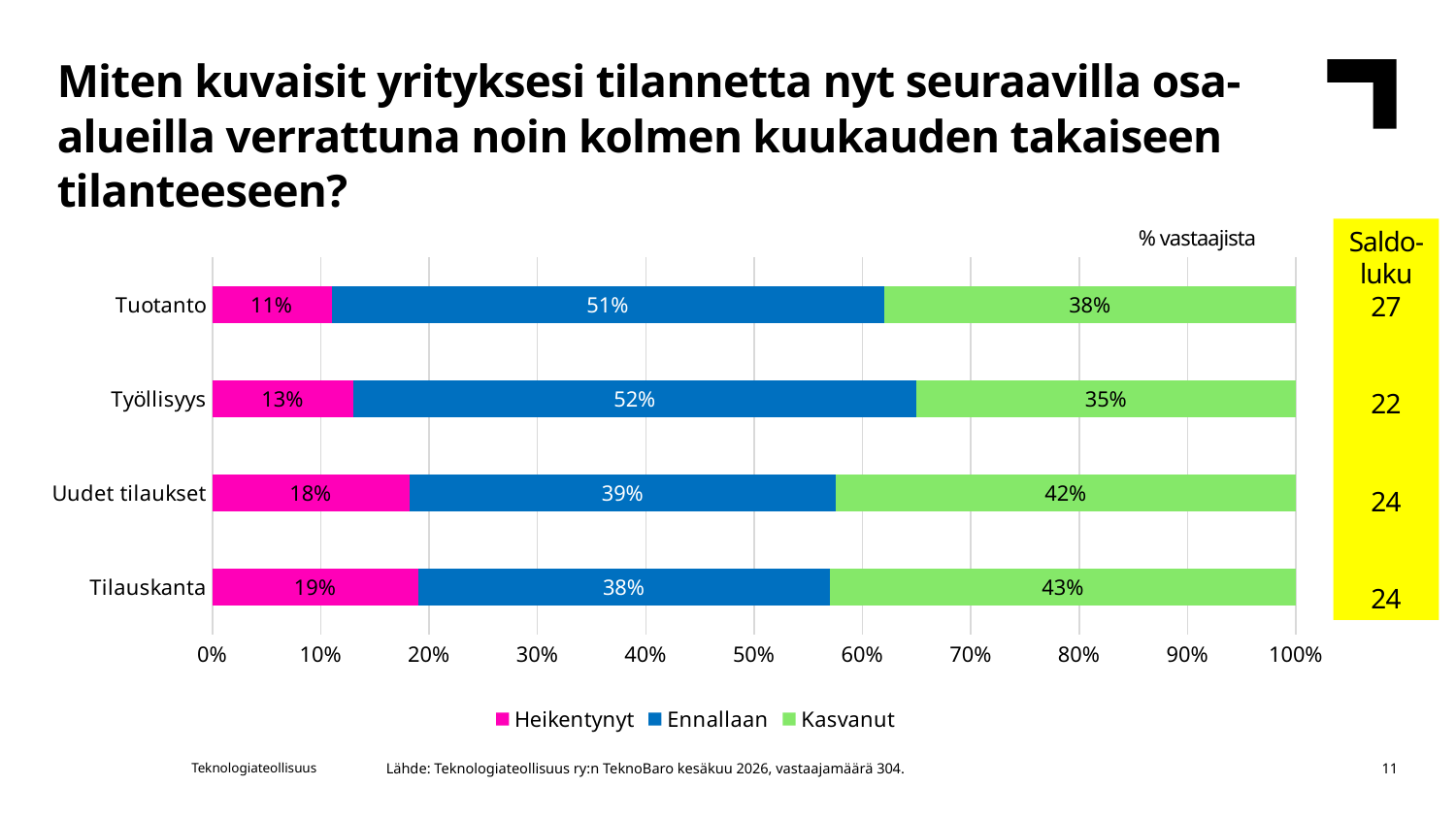
What kind of chart is shown on the slide? Stacked bar chart How many categories are shown on the y axis of the chart? 4 What is the difference between the 'Ennallaan' values for Työllisyys and Tilauskanta? 14% Which is larger: the 'Kasvanut' value for Tuotanto or for Uudet tilaukset? Uudet tilaukset Which category has the lowest 'Kasvanut' share? Työllisyys How many series does the legend list? 3 What is the Saldoluku value shown for Tuotanto? 27 Which category has the highest 'Heikentynyt' share? Tilauskanta What is the total of the stacked bar for Työllisyys? 100% What percentage of respondents reported 'Heikentynyt' for Tuotanto? 11% What is the 'Ennallaan' value for Uudet tilaukset? 39% What is the 'Kasvanut' value for Tilauskanta? 43%